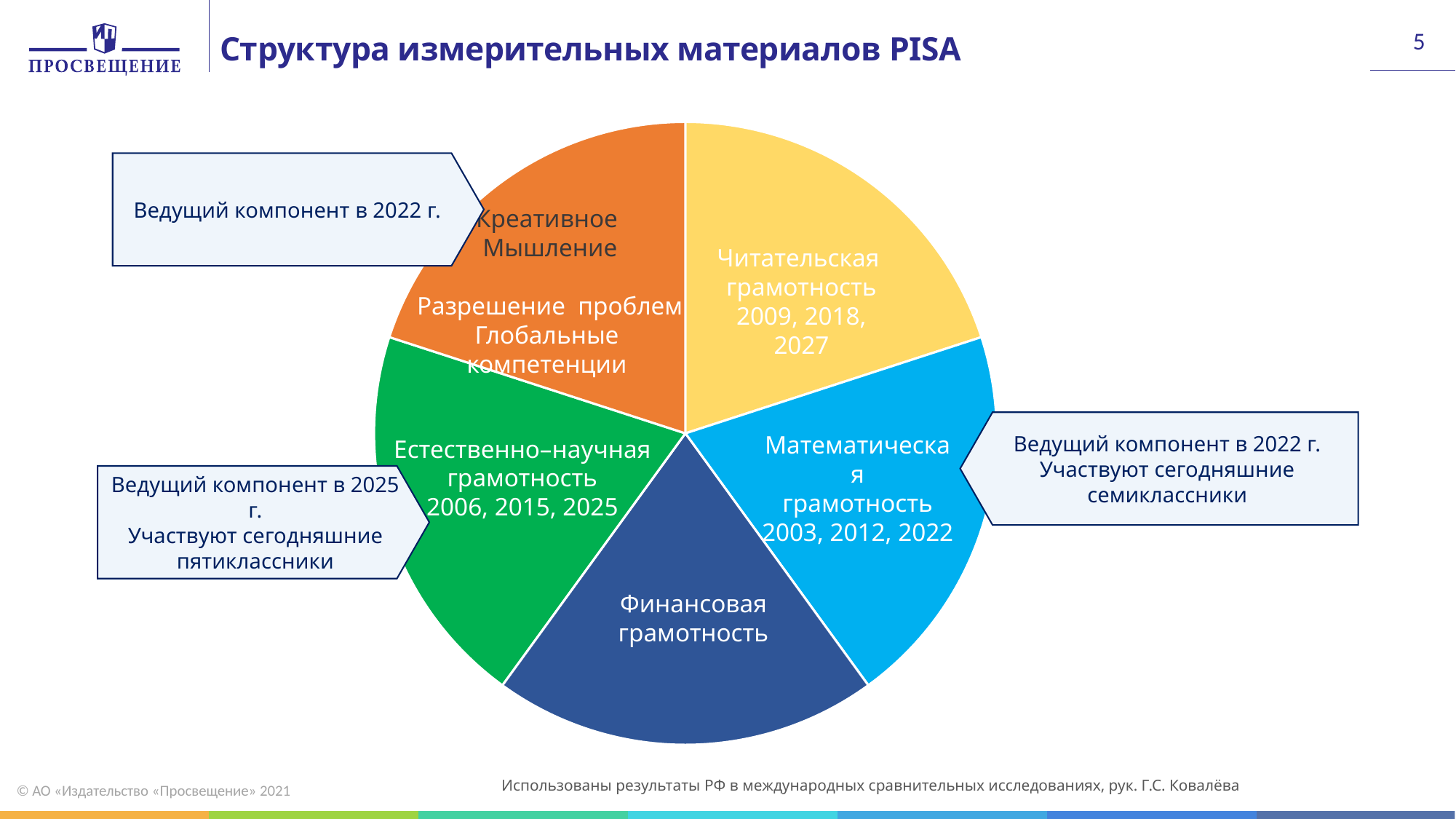
What is the title of the slide containing the pie chart? Структура измерительных материалов PISA How many slices does the pie chart have? 5 Which years are printed in the slice labelled Читательская грамотность? 2009, 2018, 2027 What colour is the slice labelled Финансовая грамотность? dark blue Which years are printed in the slice labelled Математическая грамотность? 2003, 2012, 2022 Which years are printed in the slice labelled Естественно-научная грамотность? 2006, 2015, 2025 What kind of chart is shown on the slide? pie chart